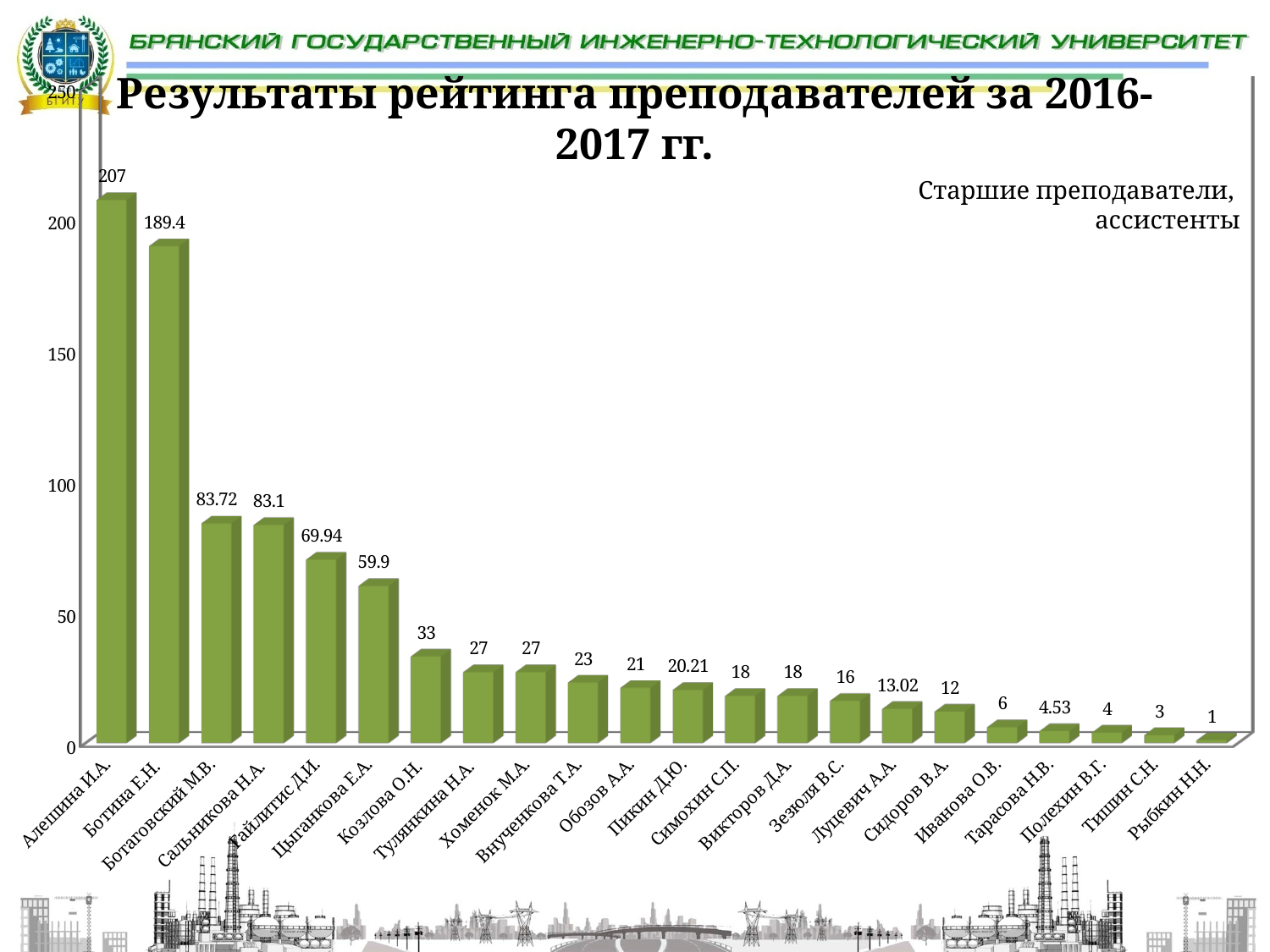
Is the value for Сальникова Н.А. greater or less than 100? less Do the values rise or fall from left to right along the x axis? fall Which category has the highest value? Алешина И.А. What is the value for Алешина И.А.? 207 What is the value for Ботина Е.Н.? 189.4 Which is larger, the value for Козлова О.Н. or the value for Внученкова Т.А.? Козлова О.Н. What is the difference between the values for Алешина И.А. and Ботина Е.Н.? 17.6 What kind of chart is shown on the slide? bar chart What is the value for Луцевич А.А.? 13.02 What is the value for Цыганкова Е.А.? 59.9 Which category has the lowest value? Рыбкин Н.Н. How many categories are shown on the chart? 22